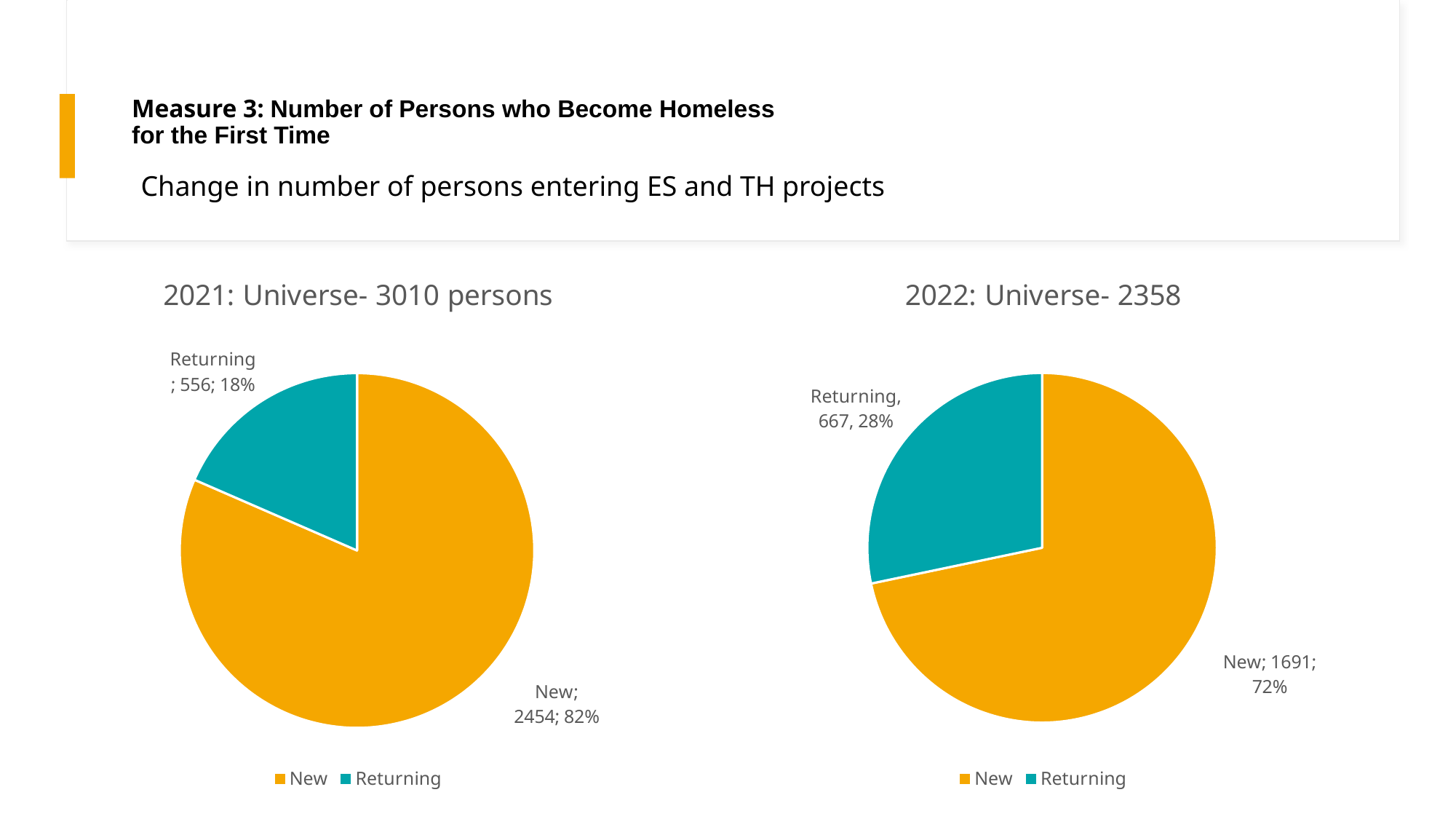
In the '2022: Universe- 2358' chart, how many persons are in the Returning slice? 667 In the '2022: Universe- 2358' chart, what share of the pie is the New slice? 72% In the '2021: Universe- 3010 persons' chart, which slice is the largest? New How many slices does the '2021: Universe- 3010 persons' chart have? 2 In the '2021: Universe- 3010 persons' chart, what share of the pie is the Returning slice? 18% In the '2021: Universe- 3010 persons' chart, how many persons are in the New slice? 2454 What type of chart is the '2022: Universe- 2358' chart? Pie chart In the '2021: Universe- 3010 persons' chart, how many persons are in the Returning slice? 556 In the '2021: Universe- 3010 persons' chart, what is the difference between the New and Returning values? 1898 In the '2022: Universe- 2358' chart, which slice is the smallest? Returning In the '2022: Universe- 2358' chart, how many persons are in the New slice? 1691 Which is larger: the Returning value in the 2021 chart or the Returning value in the 2022 chart? 2022 chart (667)